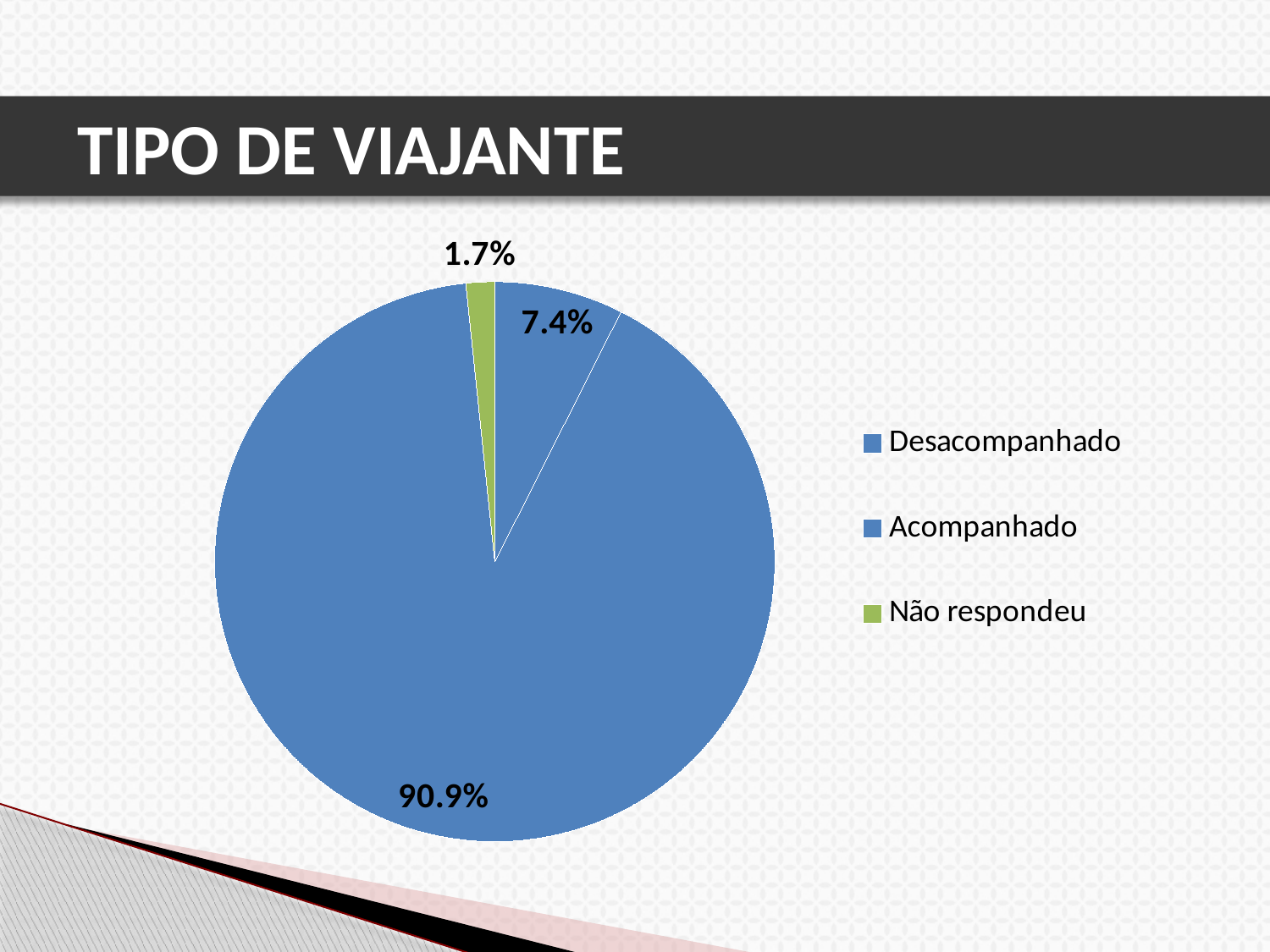
What type of chart is shown on the slide? pie chart How many categories does the legend of the pie chart list? 3 What share of the pie does the 'Não respondeu' slice represent? 1.7% Which is larger, the 7.4% slice or the 'Não respondeu' slice? the 7.4% slice What is the value of the smallest slice in the pie chart? 1.7% What is the value of the largest slice in the pie chart? 90.9% What is the difference between the largest slice (90.9%) and the 7.4% slice? 83.5% Is the largest slice of the pie chart greater or less than 50%? greater What is the difference between the 7.4% slice and the 1.7% slice? 5.7% What colour is the 'Não respondeu' slice in the pie chart? green What is the title of the slide containing the pie chart? TIPO DE VIAJANTE Which category has the smallest slice in the pie chart? Não respondeu